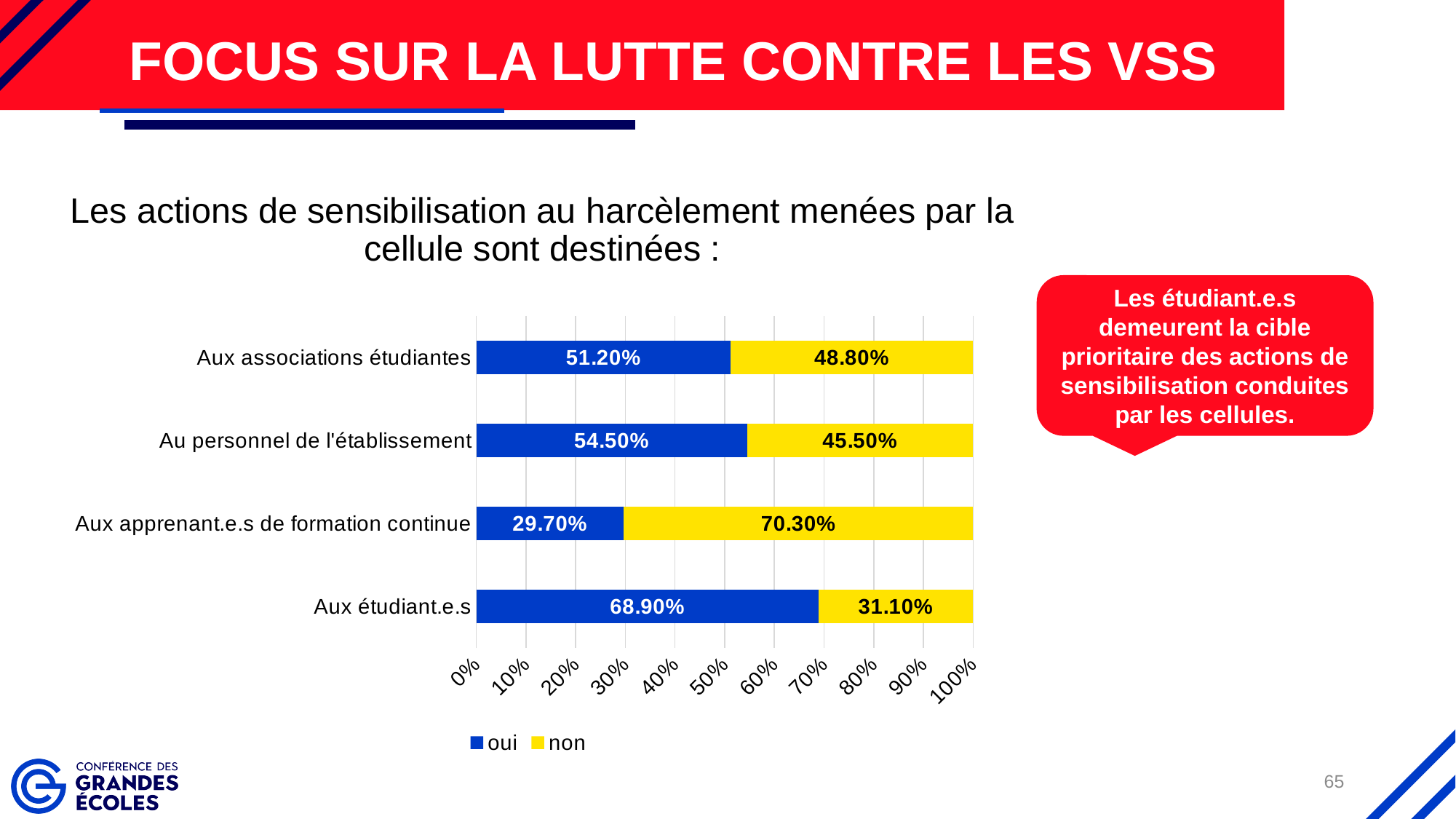
What is the 'oui' value for 'Aux étudiant.e.s'? 68.90% What is the 'non' value for 'Aux apprenant.e.s de formation continue'? 70.30% What is the difference between the 'oui' values for 'Aux étudiant.e.s' and 'Aux apprenant.e.s de formation continue'? 39.20% Which category has the highest 'oui' value? Aux étudiant.e.s What colour represents the 'non' series in the chart? Yellow How many categories are shown in the chart? 4 How many series does the legend list? 2 What kind of chart is shown on the slide? Stacked bar chart Which is larger: the 'oui' value for 'Au personnel de l'établissement' or the 'oui' value for 'Aux associations étudiantes'? Au personnel de l'établissement What is the 'oui' value for 'Au personnel de l'établissement'? 54.50% Which category has the lowest 'oui' value? Aux apprenant.e.s de formation continue What is the 'non' value for 'Aux associations étudiantes'? 48.80%